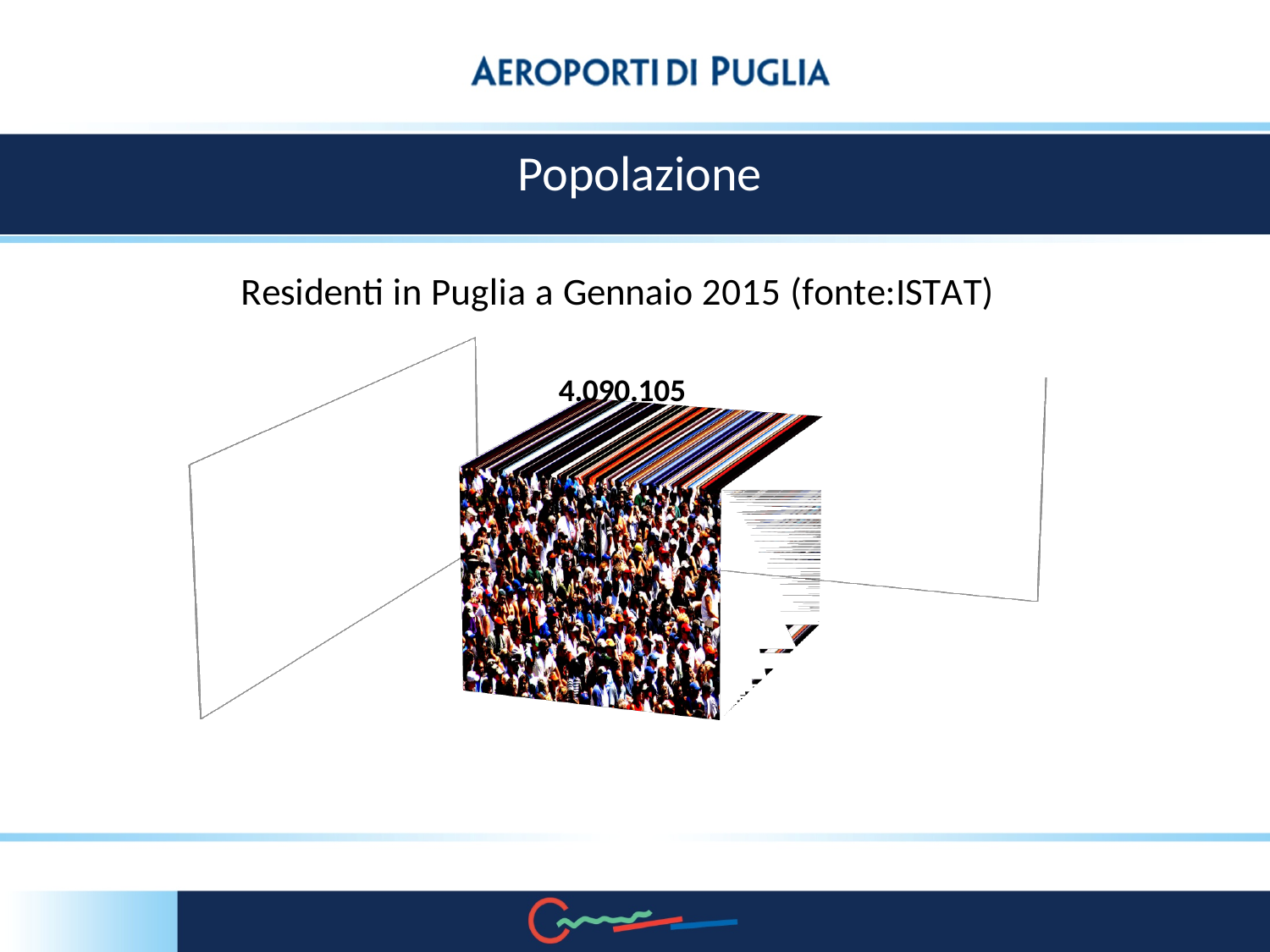
What is the bar in the chart filled with? a photo of a crowd of people How many bars are plotted in the chart? 1 What value is printed as the data label on the bar in the chart? 4.090.105 Is the value shown on the bar greater or less than 4.000.000? greater What is the title of the chart? Residenti in Puglia a Gennaio 2015 (fonte:ISTAT) What kind of chart is shown on the slide? bar chart